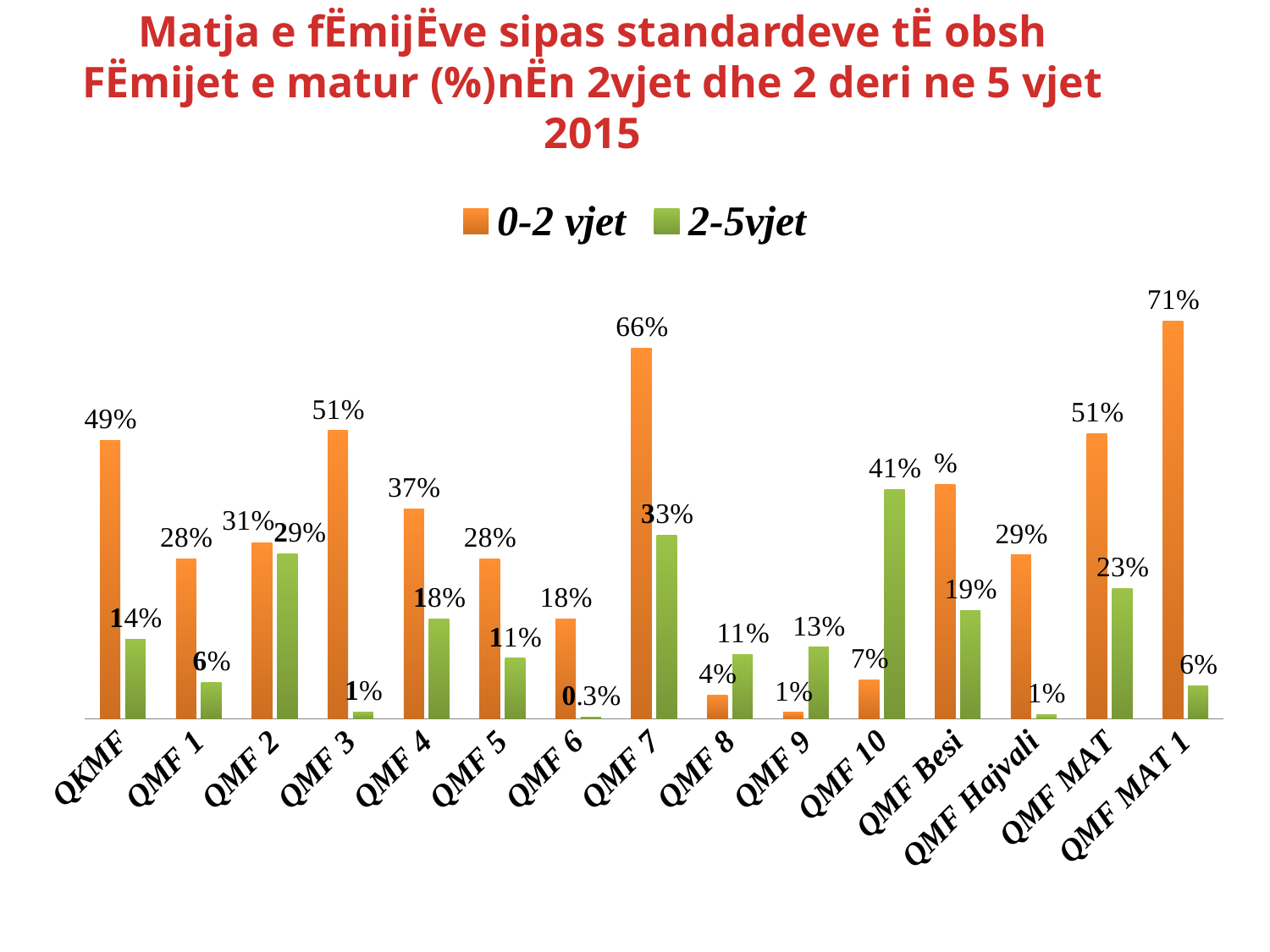
How many series does the legend list? 2 Which category has the highest 2-5vjet value? QMF 10 What is the difference between the 0-2 vjet and 2-5vjet values for QMF 7? 33% Which category has the highest 0-2 vjet value? QMF MAT 1 How many categories are shown on the x axis? 15 What is the 2-5vjet value for QMF 10? 41% Which category has the lowest 2-5vjet value? QMF 6 What is the 2-5vjet value for QMF 6? 0.3% What kind of chart is shown on the slide? Bar chart Which is larger for QMF 9: the 0-2 vjet value or the 2-5vjet value? 2-5vjet What is the 0-2 vjet value for QMF 7? 66% Which colour represents the 2-5vjet series? Green